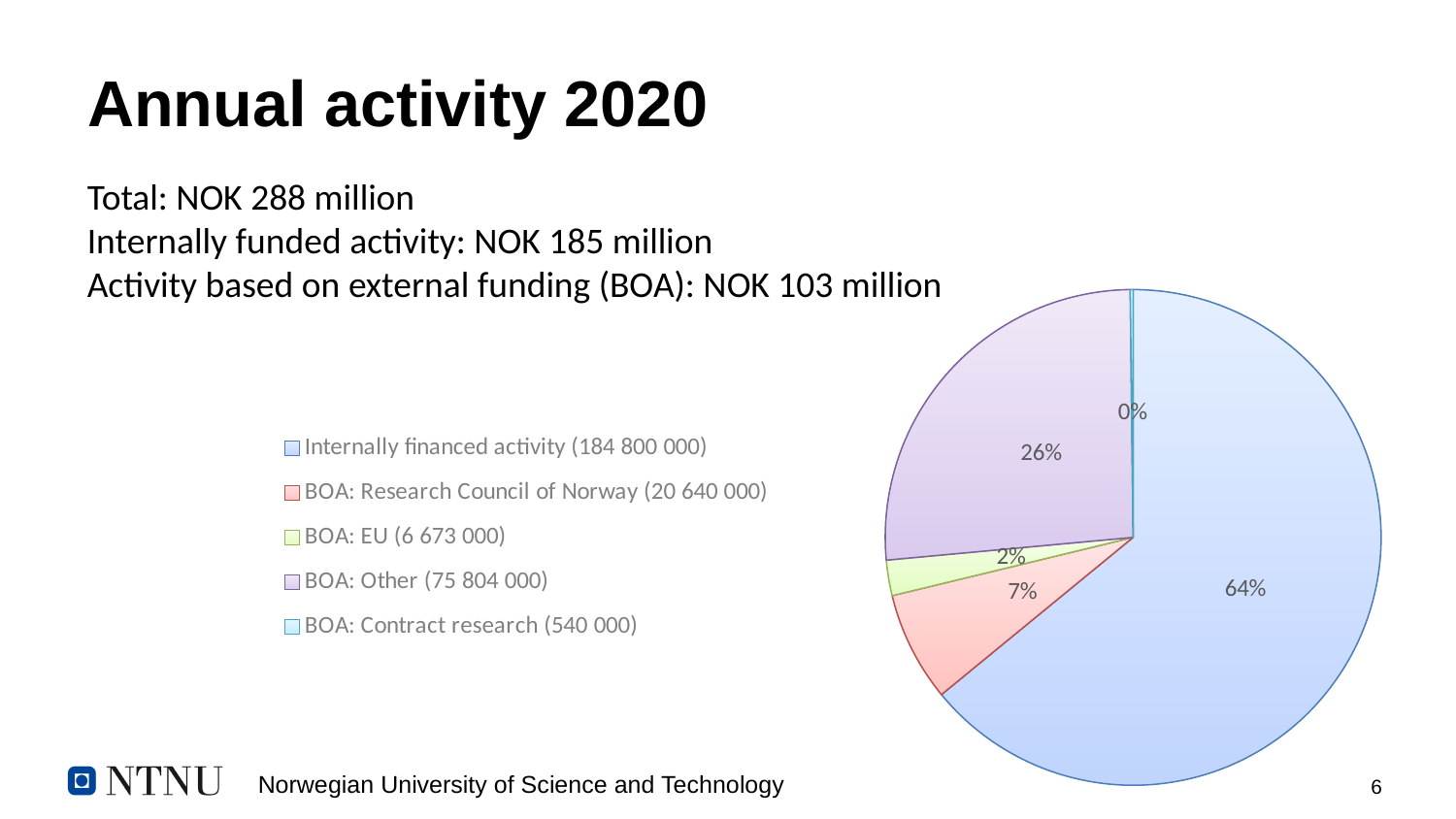
Which slice is the largest in the pie chart? Internally financed activity What share of the pie is Internally financed activity? 64% What share of the pie is BOA: Other? 26% What share of the pie is BOA: Research Council of Norway? 7% Which slice is the smallest in the pie chart? BOA: Contract research What is the difference in percentage points between the Internally financed activity share and the BOA: Other share? 38 What kind of chart is shown on the slide? pie chart How many slices does the pie chart have? 5 Which is larger, the share for BOA: Other or the share for BOA: Research Council of Norway? BOA: Other How many entries does the legend list? 5